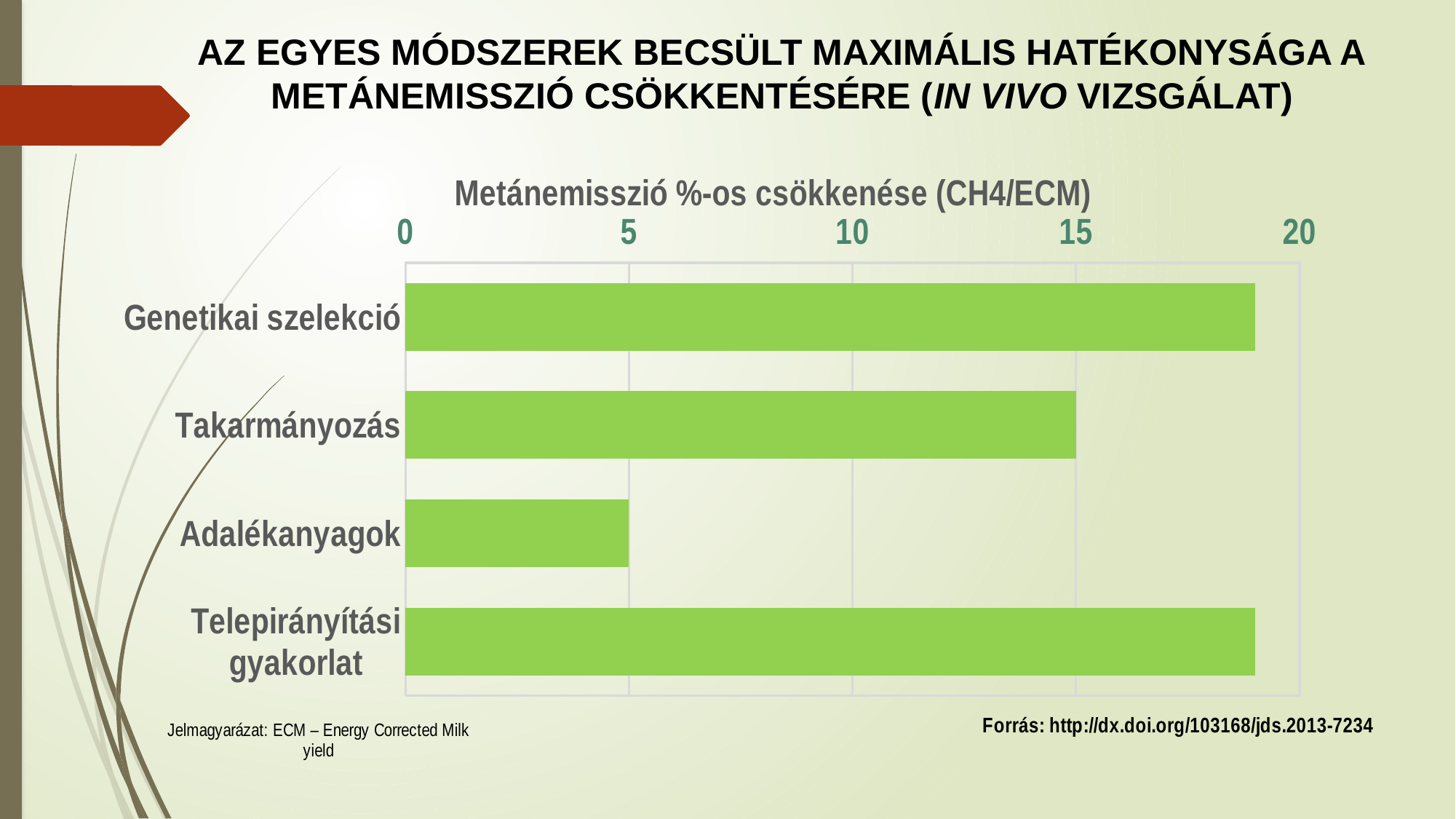
How many categories are plotted in the chart? 4 What is the difference between the values for Takarmányozás and Adalékanyagok? 10 What is the value for Takarmányozás? 15 What kind of chart is shown on the slide? bar chart Which is larger, the value for Adalékanyagok or the value for Telepirányítási gyakorlat? Telepirányítási gyakorlat What is the highest value shown on the horizontal axis? 20 Is the value for Telepirányítási gyakorlat greater or less than 20? less Which category has the lowest value? Adalékanyagok What is the value for Adalékanyagok? 5 Is the value for Genetikai szelekció greater or less than 15? greater Which is larger, the value for Genetikai szelekció or the value for Takarmányozás? Genetikai szelekció What is the title of the chart? Metánemisszió %-os csökkenése (CH4/ECM)